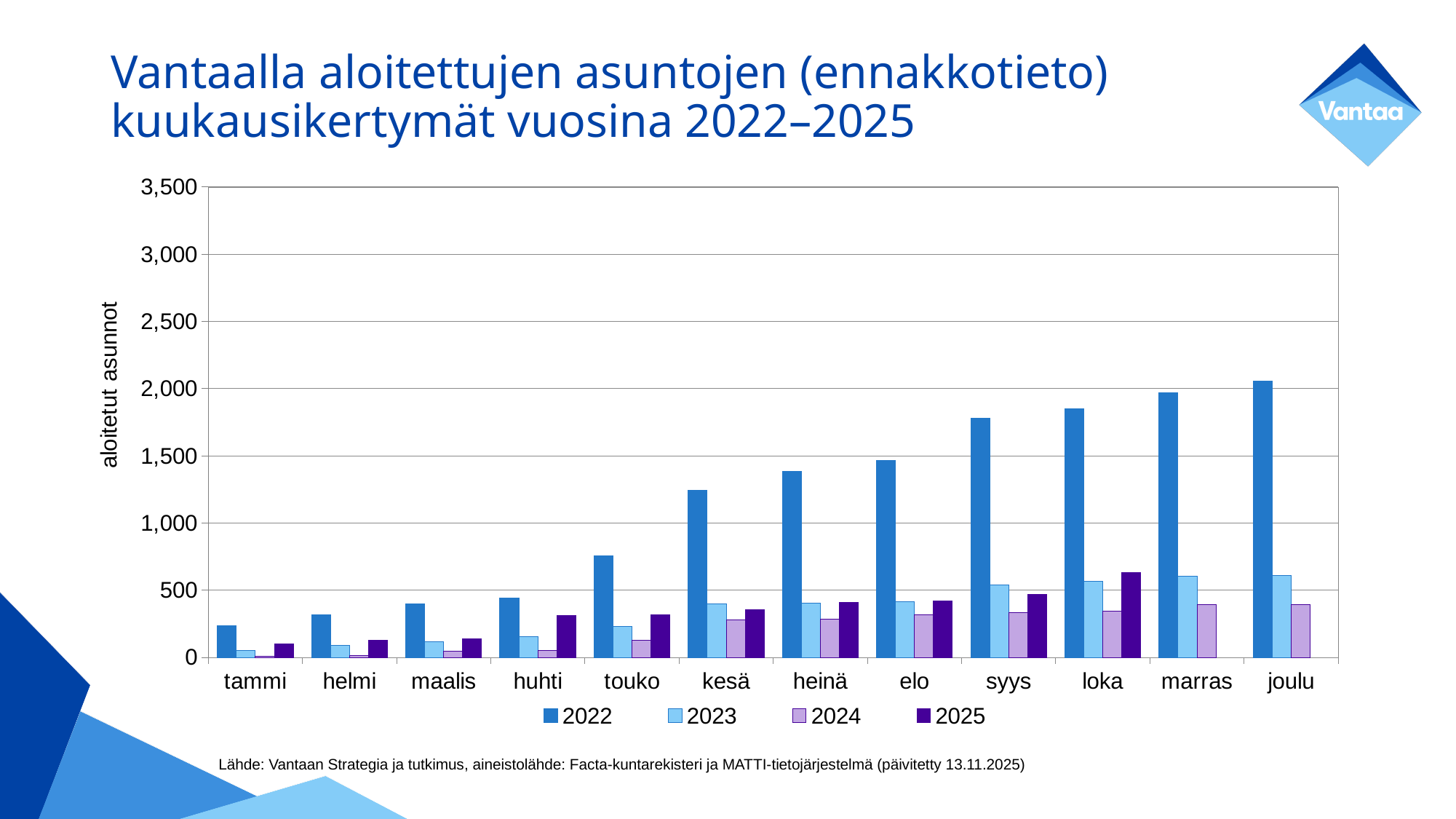
How many series does the legend list? 4 Is the 2022 value for syys greater or less than 1,500? greater Do the 2022 values rise or fall from tammi to joulu? rise In which month is the 2022 value highest? joulu In which month is the 2024 value lowest? tammi What is the title of the y axis? aloitetut asunnot What kind of chart is shown on the slide? bar chart For kesä, which series has the larger value, 2022 or 2023? 2022 Is the 2022 value for joulu greater or less than 2,000? greater How many months are shown on the x axis? 12 Is the 2022 value for touko greater or less than 1,000? less